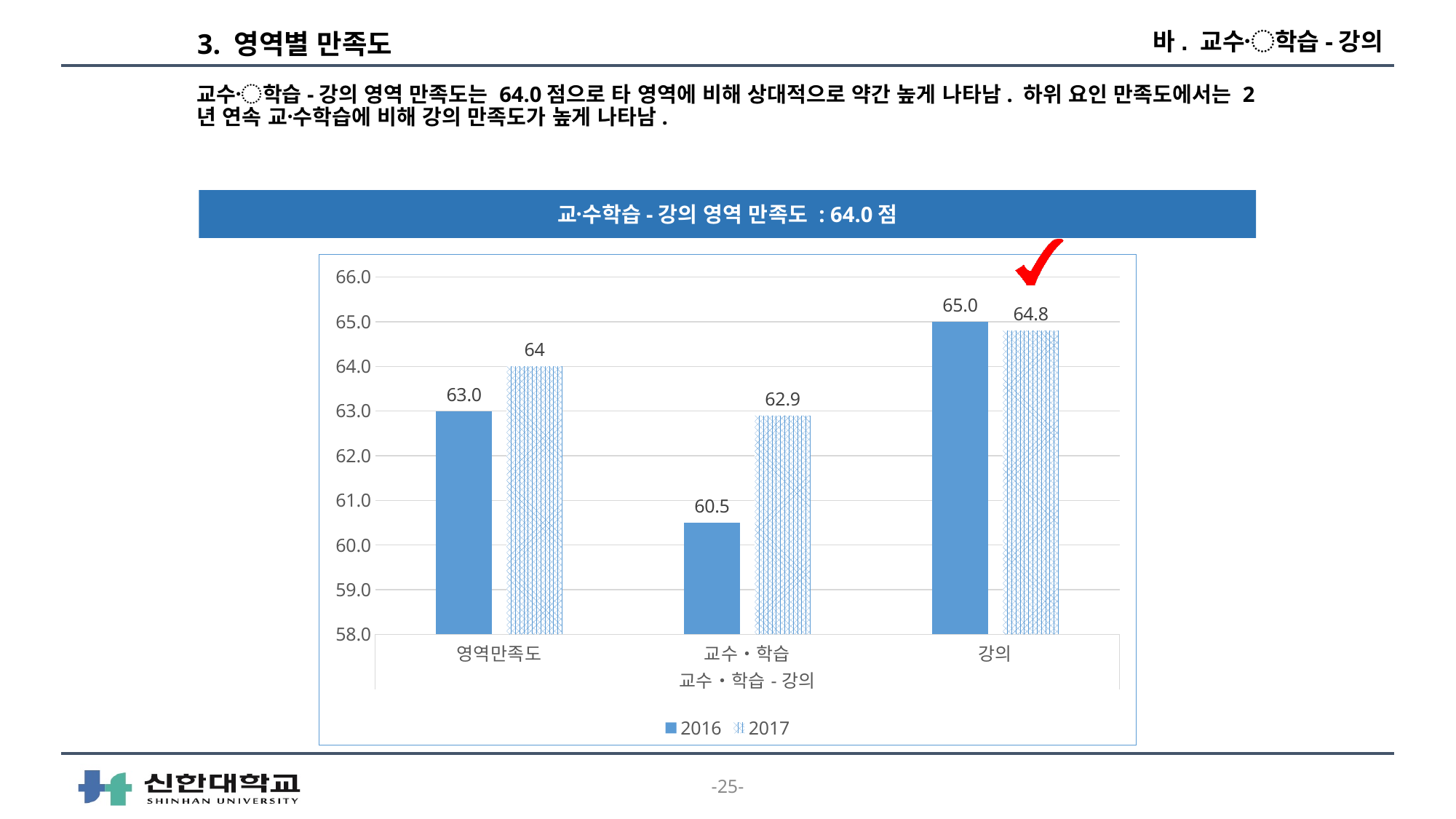
How many categories are shown on the x axis? 3 What is the 2016 value for 강의? 65.0 Which is larger for 강의, the 2016 value or the 2017 value? 2016 What is the 2017 value for 교수·학습? 62.9 Which category has the highest 2017 value? 강의 What is the 2016 value for 영역만족도? 63.0 What is the difference between the 2017 and 2016 values for 교수·학습? 2.4 What are the two series listed in the legend? 2016 and 2017 What kind of chart is shown on the slide? Bar chart Which category has the lowest 2016 value? 교수·학습 What is the 2017 value for 영역만족도? 64 How many series does the legend list? 2